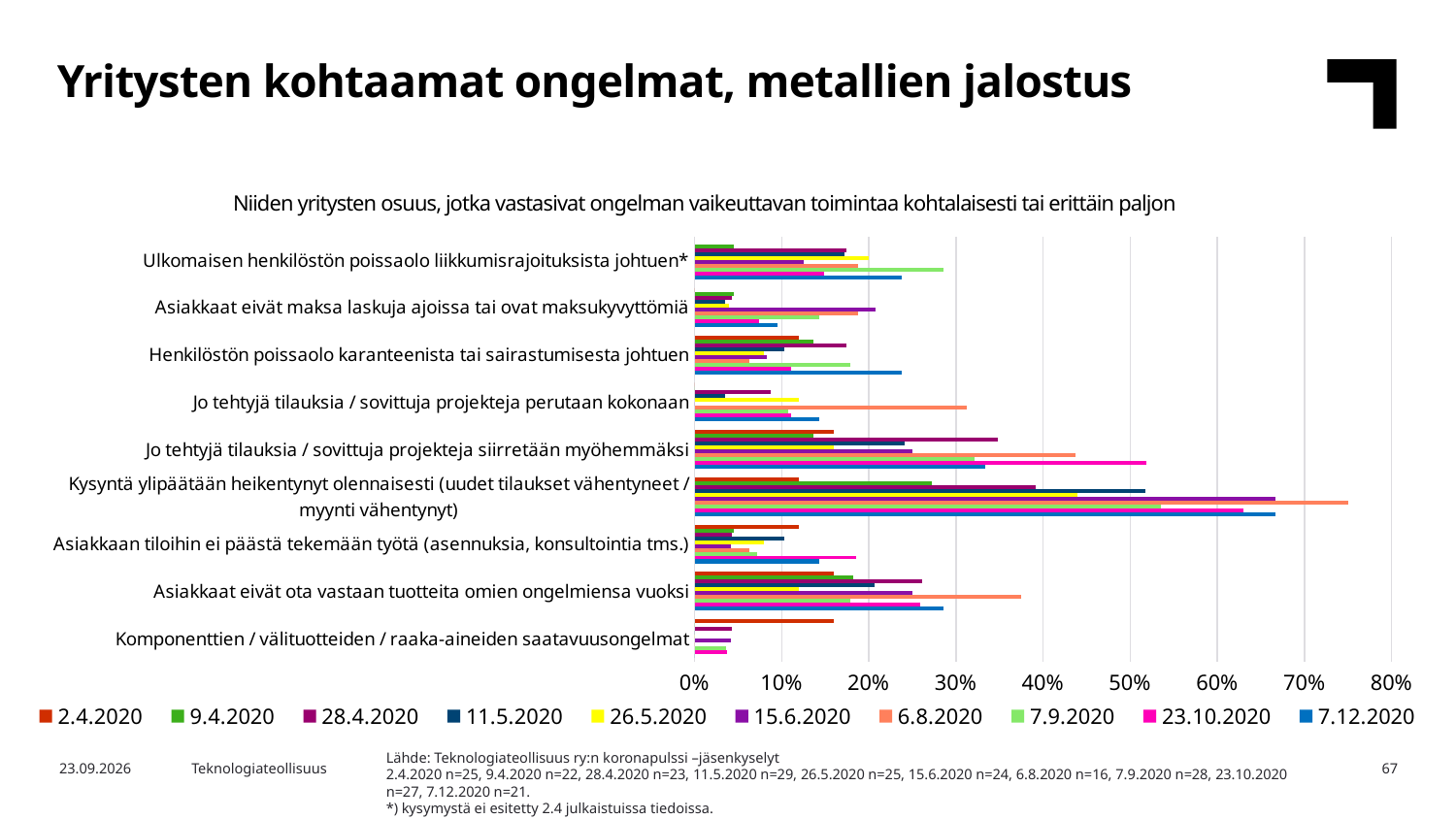
For the 6.8.2020 series, which is larger: 'Kysyntä ylipäätään heikentynyt olennaisesti' or 'Jo tehtyjä tilauksia / sovittuja projekteja siirretään myöhemmäksi'? Kysyntä ylipäätään heikentynyt olennaisesti How many problem categories are listed on the chart's vertical axis? 9 Is the 26.5.2020 value for 'Jo tehtyjä tilauksia / sovittuja projekteja siirretään myöhemmäksi' greater or less than 40%? less Is the 6.8.2020 value for 'Kysyntä ylipäätään heikentynyt olennaisesti' greater or less than 70%? greater What is the first series listed in the chart legend? 2.4.2020 What kind of chart is shown on the slide? Bar chart What is the highest value shown on the chart's horizontal axis? 80% Is the 9.4.2020 value for 'Asiakkaat eivät maksa laskuja ajoissa tai ovat maksukyvyttömiä' greater or less than 10%? less How many series (survey dates) does the legend list? 10 Which category has the longest bar on the chart? Kysyntä ylipäätään heikentynyt olennaisesti (uudet tilaukset vähentyneet / myynti vähentynyt)